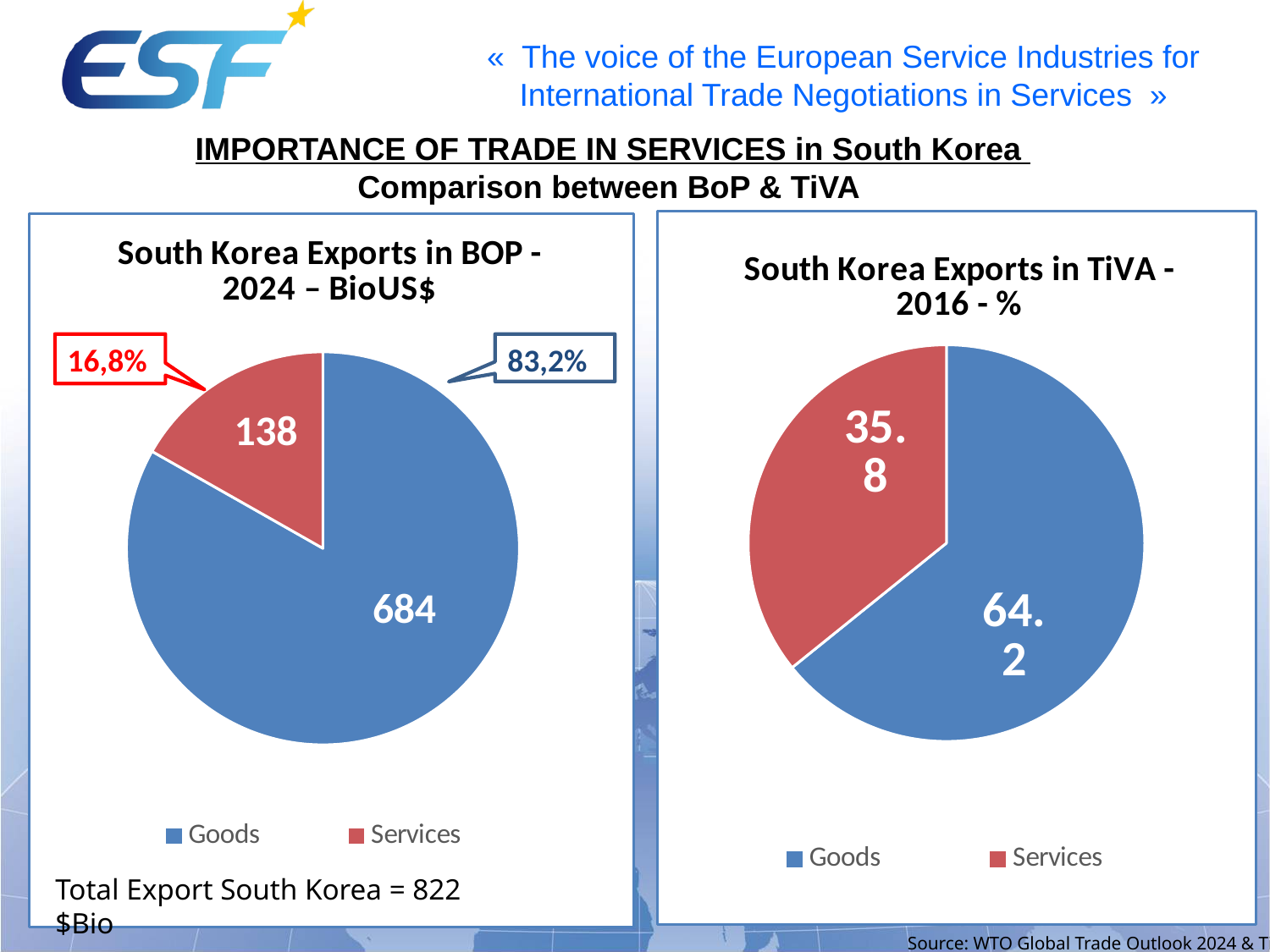
In the 'South Korea Exports in BOP - 2024' chart, what share of the pie does Goods represent? 83,2% In the 'South Korea Exports in BOP - 2024' chart, what is the difference between the Goods and Services values? 546 In the 'South Korea Exports in TiVA - 2016' chart, what colour is the Services slice? Red In the 'South Korea Exports in BOP - 2024' chart, what is the value for Services? 138 In the 'South Korea Exports in BOP - 2024' chart, which category is the smallest? Services What kind of chart is the 'South Korea Exports in TiVA - 2016' chart? Pie chart In the 'South Korea Exports in BOP - 2024' chart, what is the value for Goods? 684 How many series does the legend of the 'South Korea Exports in BOP - 2024' chart list? 2 In the 'South Korea Exports in BOP - 2024' chart, what share of the pie does Services represent? 16,8% In the 'South Korea Exports in TiVA - 2016' chart, what is the value for Goods? 64.2 In the 'South Korea Exports in TiVA - 2016' chart, what is the value for Services? 35.8 In the 'South Korea Exports in TiVA - 2016' chart, which category is the largest? Goods